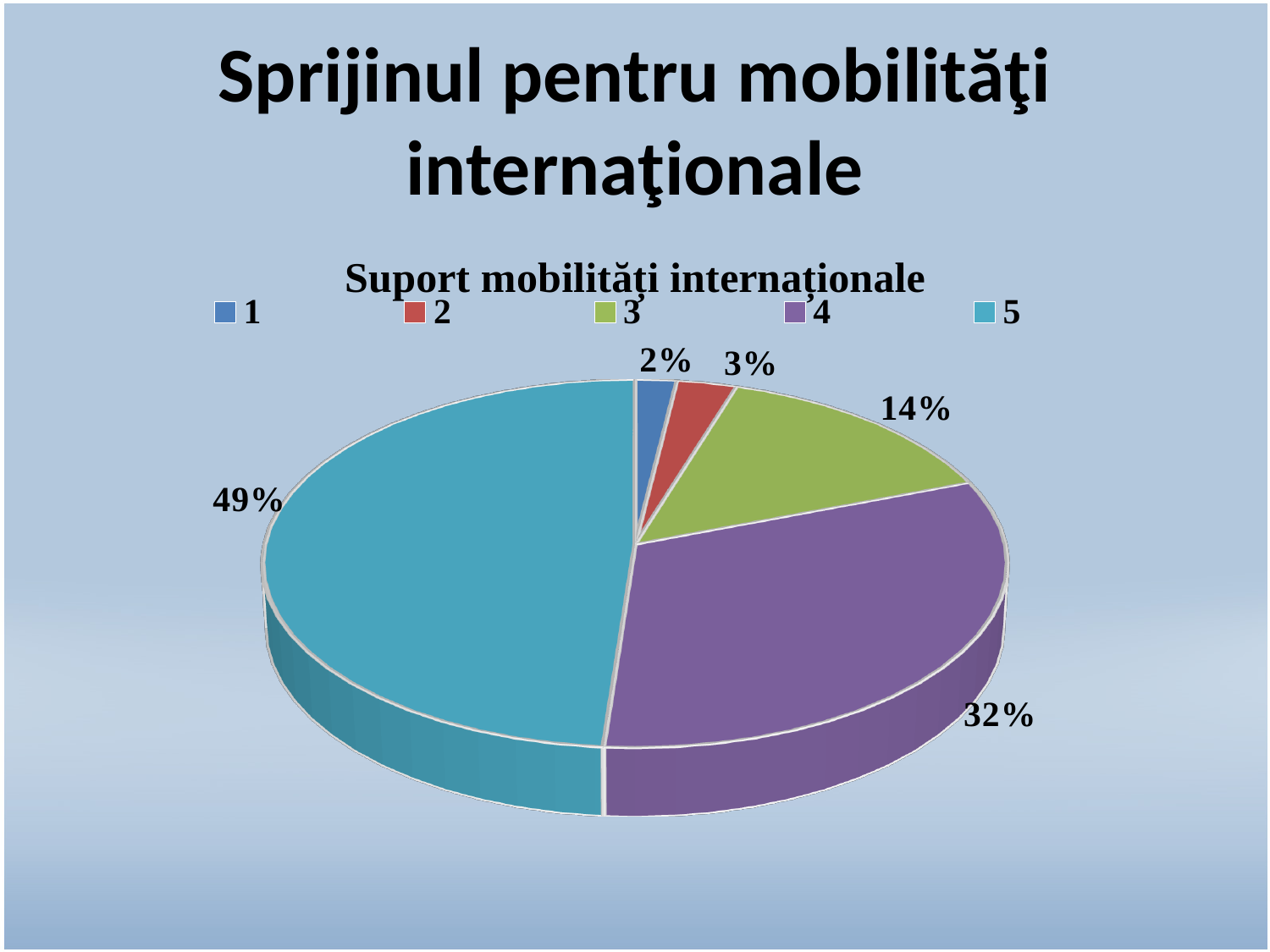
What share of the pie does category 3 have? 14% Which is larger, the slice for category 3 or the slice for category 4? 4 What share of the pie does category 1 have? 2% Which category has the smallest slice? 1 What share of the pie does category 2 have? 3% What is the title of the chart? Suport mobilităţi internaţionale Which category has the largest slice? 5 What share of the pie does category 4 have? 32% What kind of chart is shown on the slide? pie chart How many categories does the legend list? 5 What is the difference in percentage points between category 5 and category 4? 17 What share of the pie does category 5 have? 49%